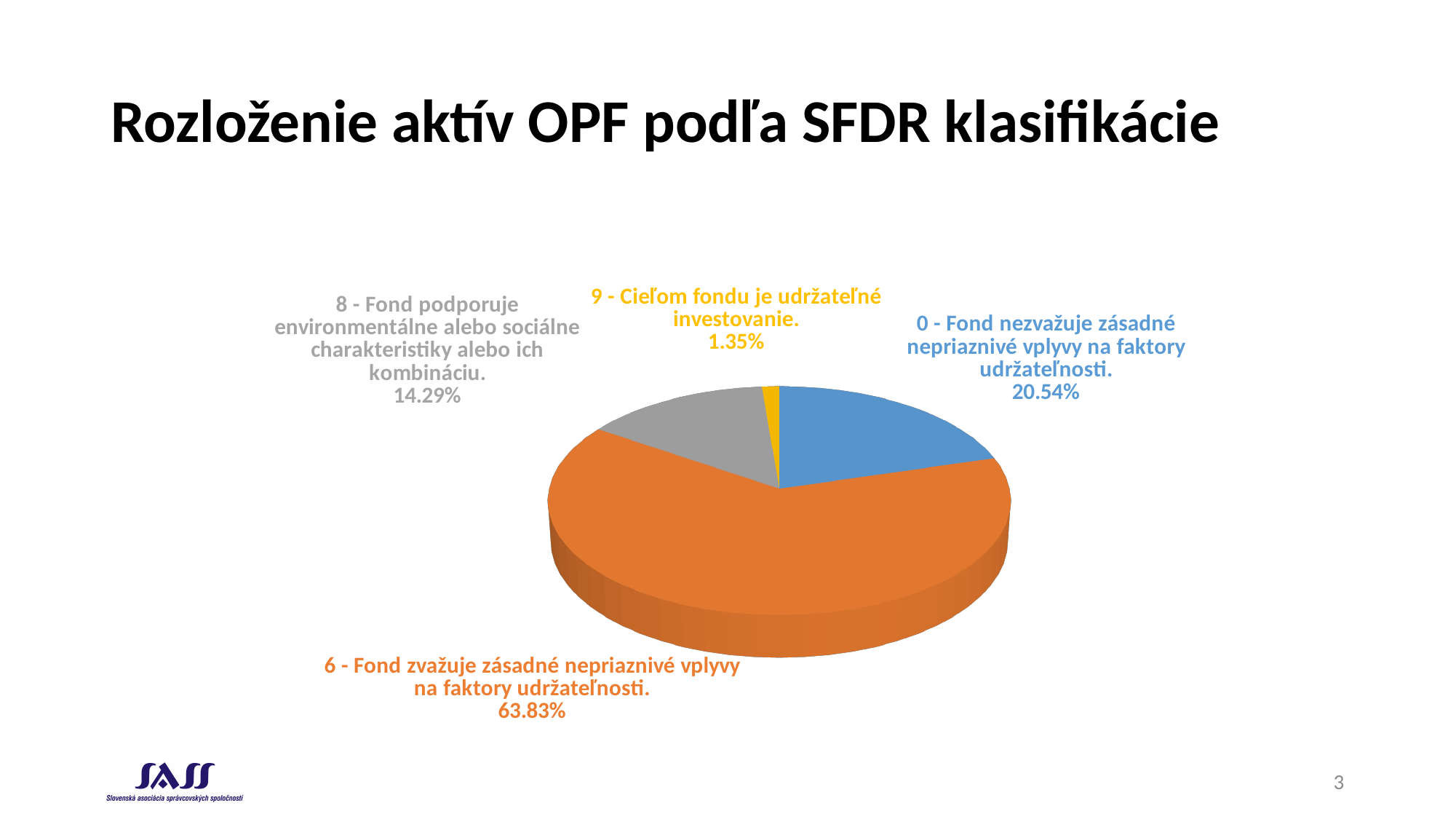
What share of OPF assets falls under category 8 (Fond podporuje environmentálne alebo sociálne charakteristiky alebo ich kombináciu)? 14.29% What colour is the slice for category 9 (Cieľom fondu je udržateľné investovanie)? yellow What share of OPF assets falls under category 0 (Fond nezvažuje zásadné nepriaznivé vplyvy na faktory udržateľnosti)? 20.54% Which SFDR category has the smallest share of OPF assets? 9 - Cieľom fondu je udržateľné investovanie. How many categories are shown in the pie chart? 4 Which has a larger share: category 0 or category 8? category 0 What share of OPF assets falls under category 9 (Cieľom fondu je udržateľné investovanie)? 1.35% What kind of chart is shown on the slide? pie chart What share of OPF assets falls under category 6 (Fond zvažuje zásadné nepriaznivé vplyvy na faktory udržateľnosti)? 63.83% Which SFDR category has the largest share of OPF assets? 6 - Fond zvažuje zásadné nepriaznivé vplyvy na faktory udržateľnosti. What is the difference in percentage points between category 0 (20.54%) and category 8 (14.29%)? 6.25 What is the title of the slide containing the pie chart? Rozloženie aktív OPF podľa SFDR klasifikácie